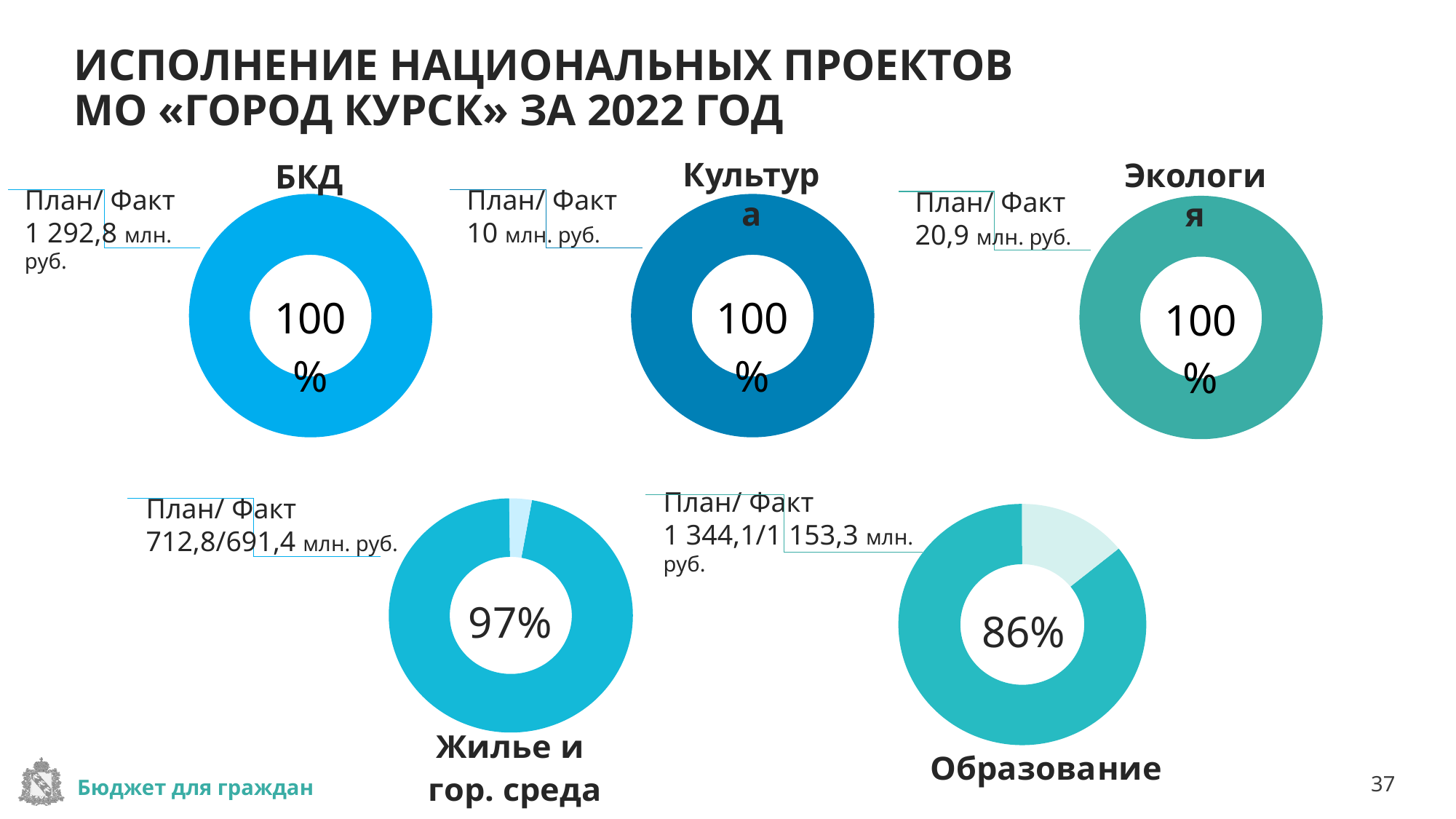
How many donut charts are shown on the slide? 5 What kind of chart is used for the "БКД" chart? Donut chart What is the plan/fact amount shown next to the "Жилье и гор. среда" chart? 712,8/691,4 млн. руб. What percentage is shown in the centre of the "Жилье и гор. среда" chart? 97% What is the difference between the percentage for "Жилье и гор. среда" and the percentage for "Образование"? 11% Which is larger, the percentage for "Жилье и гор. среда" or for "Образование"? Жилье и гор. среда Which chart shows the lowest execution percentage? Образование What percentage is shown in the centre of the "Образование" chart? 86% What percentage is shown in the centre of the "Экология" chart? 100% What is the plan/fact amount shown next to the "Культура" chart? 10 млн. руб. How many charts show 100%? 3